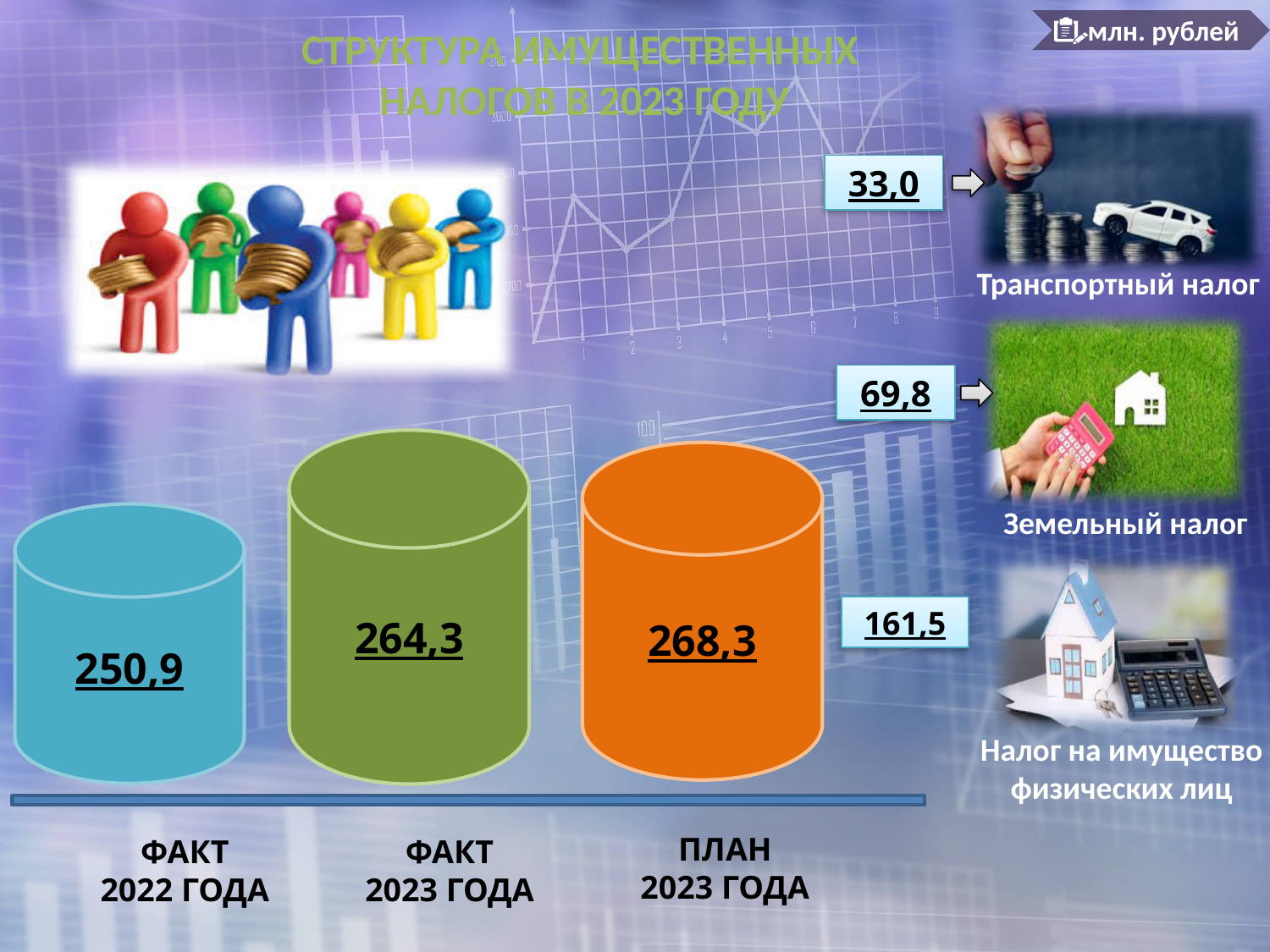
What is the value for ФАКТ 2022 ГОДА? 250,9 How many categories are shown in the chart? 3 Which is larger, ФАКТ 2022 ГОДА or ПЛАН 2023 ГОДА? ПЛАН 2023 ГОДА What is the value for ФАКТ 2023 ГОДА? 264,3 What is the value for ПЛАН 2023 ГОДА? 268,3 Which category has the lowest value? ФАКТ 2022 ГОДА Which category has the highest value? ПЛАН 2023 ГОДА Do the values rise or fall from ФАКТ 2022 ГОДА to ПЛАН 2023 ГОДА? rise What kind of chart is shown on the slide? bar chart What is the difference between ФАКТ 2023 ГОДА and ФАКТ 2022 ГОДА? 13,4 What unit of measurement is indicated on the slide? млн. рублей What is the difference between ПЛАН 2023 ГОДА and ФАКТ 2023 ГОДА? 4,0